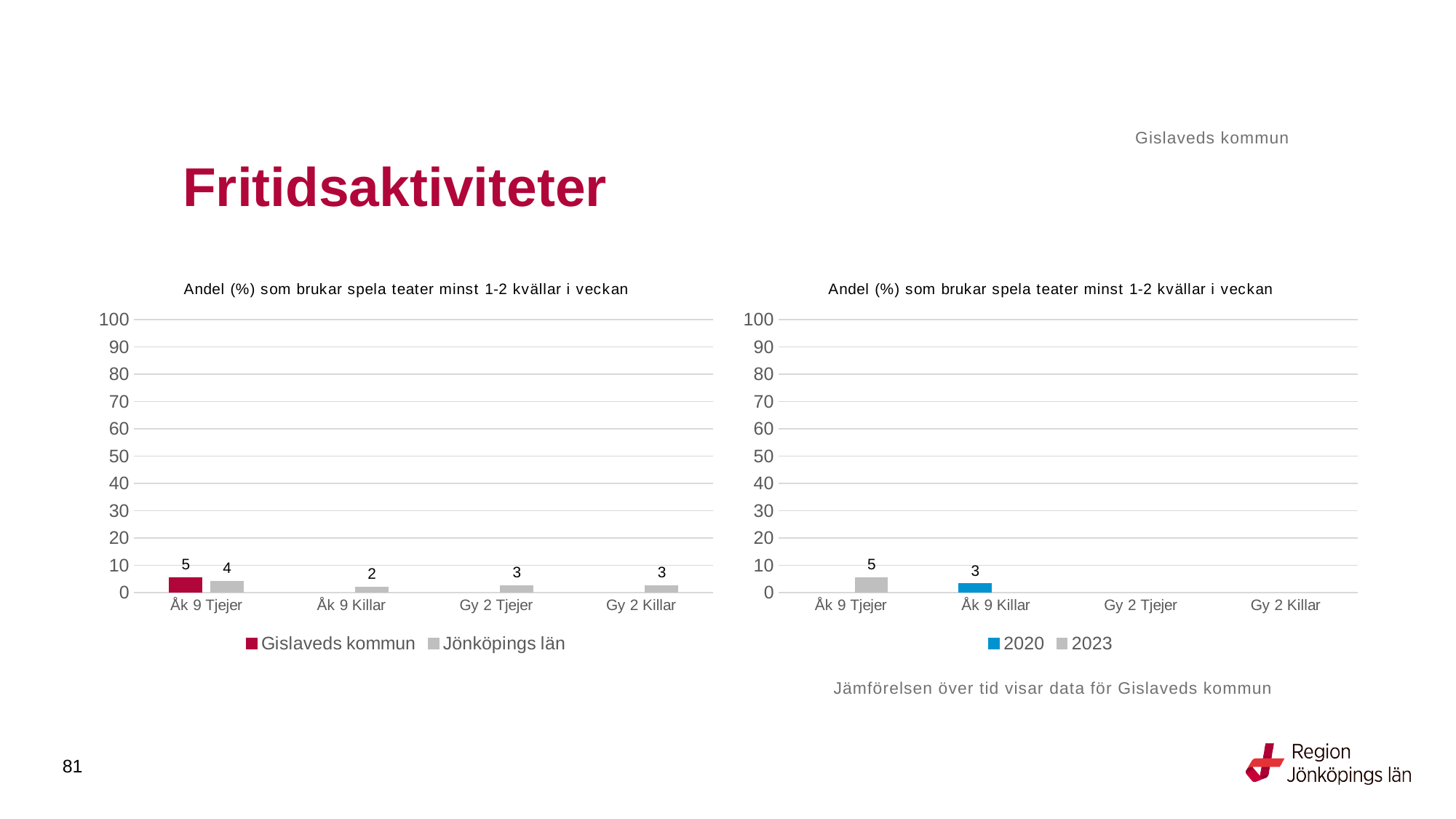
In the left chart, which category has the lowest value for Jönköpings län? Åk 9 Killar In the left chart, what is the difference between Gislaveds kommun and Jönköpings län for Åk 9 Tjejer? 1 In the right chart, what is the value for 2023 for Åk 9 Tjejer? 5 In the left chart, how many series does the legend list? 2 In the left chart, how many categories are shown on the x axis? 4 In the left chart, what is the value for Jönköpings län for Åk 9 Tjejer? 4 In the left chart, what is the value for Jönköpings län for Åk 9 Killar? 2 What kind of chart is the right chart? Bar chart In the left chart, what is the value for Gislaveds kommun for Åk 9 Tjejer? 5 In the right chart, which two series does the legend list? 2020 and 2023 In the left chart, which is larger for Åk 9 Tjejer: Gislaveds kommun or Jönköpings län? Gislaveds kommun In the right chart, what is the value for 2020 for Åk 9 Killar? 3